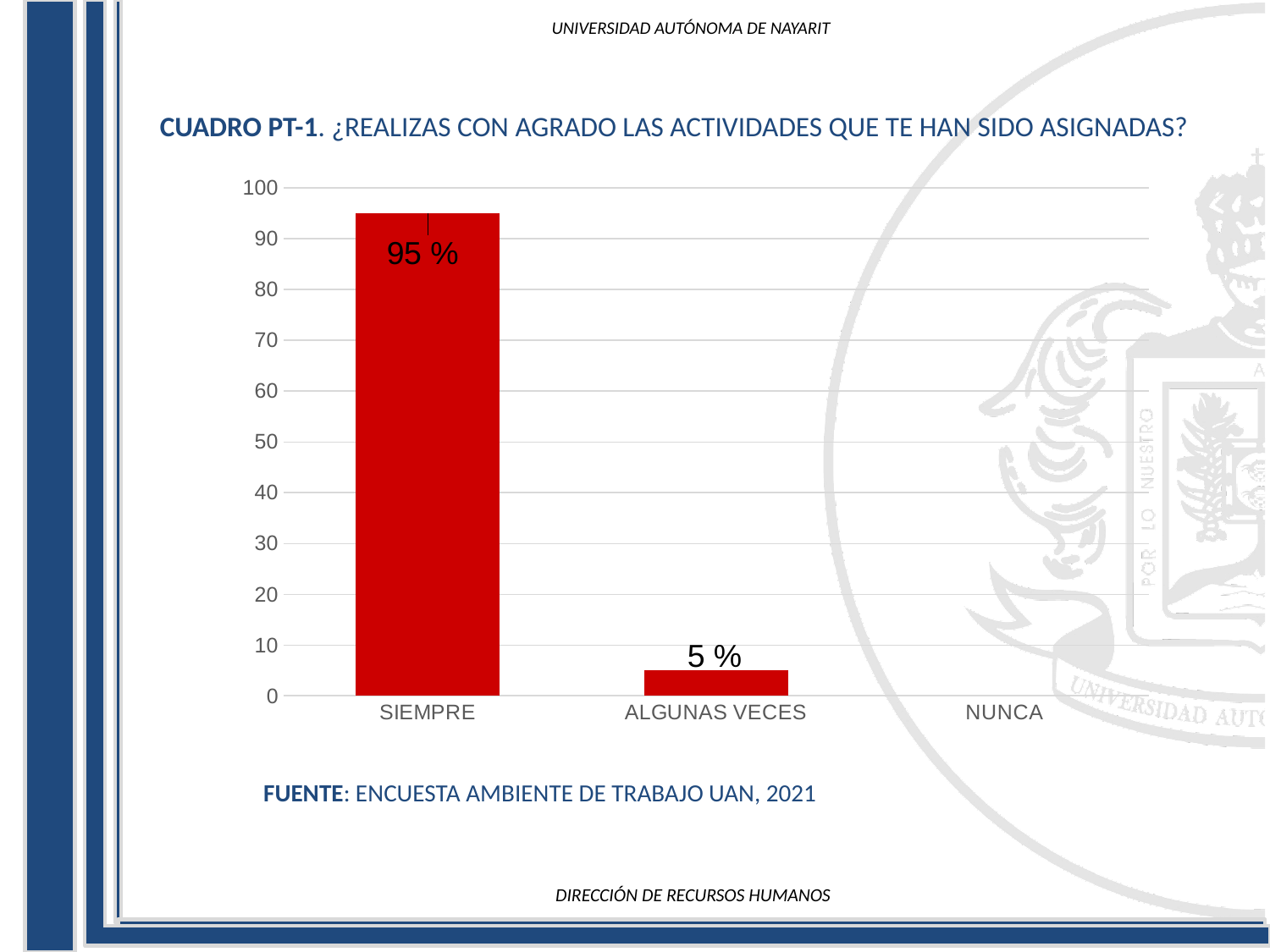
Is the value for ALGUNAS VECES greater or less than 10? less What kind of chart is shown on the slide? bar chart What is the value for ALGUNAS VECES? 5 % What colour are the bars in the chart? red Which category has the highest value? SIEMPRE How many categories are shown on the x axis? 3 What is the difference between the values for SIEMPRE and ALGUNAS VECES? 90 % What is the value for SIEMPRE? 95 % Which is larger, the value for SIEMPRE or the value for ALGUNAS VECES? SIEMPRE What is the source cited below the chart? ENCUESTA AMBIENTE DE TRABAJO UAN, 2021 Is the value for SIEMPRE greater or less than 90? greater